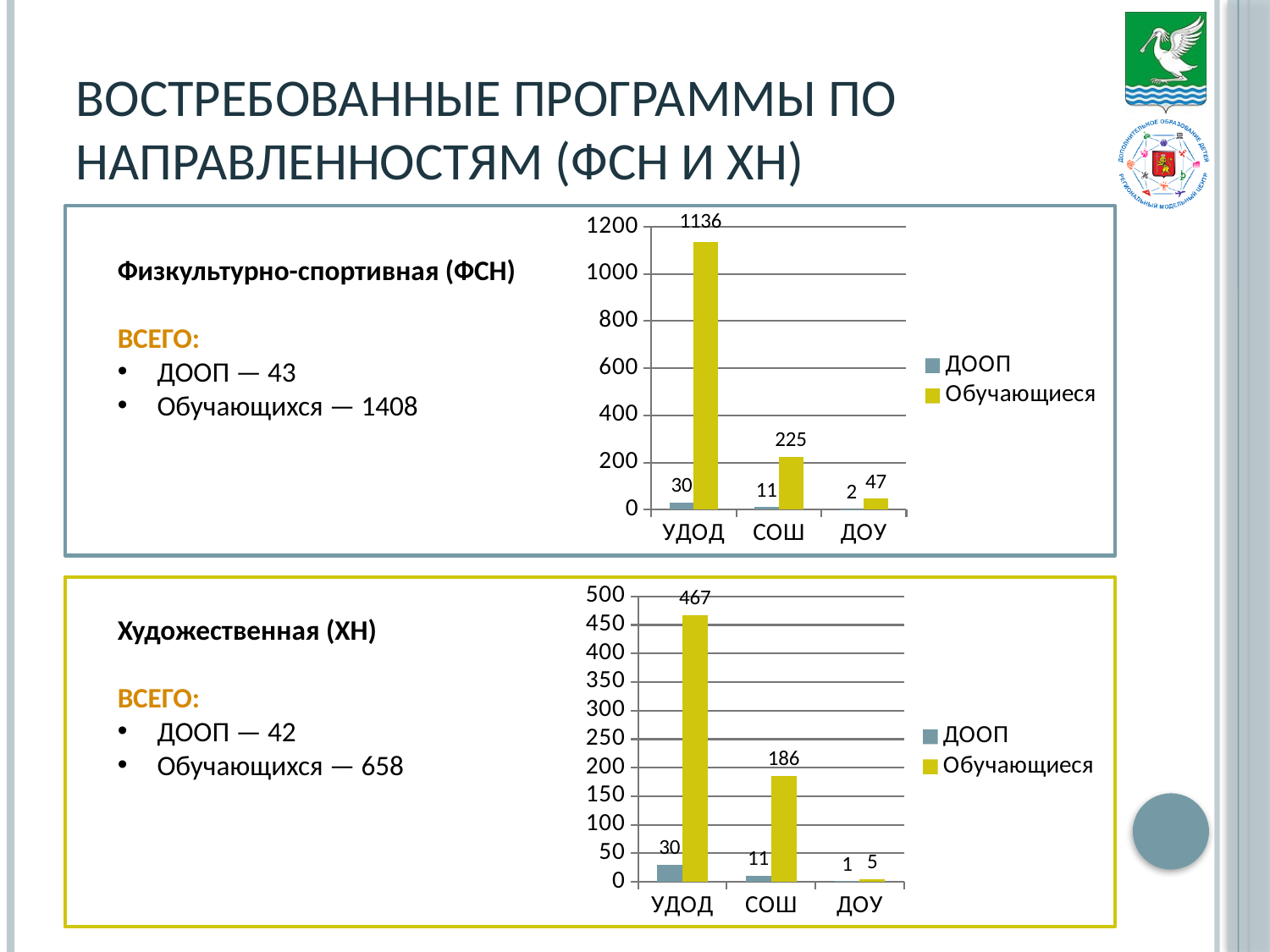
In the bottom chart (Художественная (ХН)), is the value of Обучающиеся for УДОД greater or less than 400? greater In the top chart (Физкультурно-спортивная (ФСН)), how many categories are shown on the x axis? 3 In the bottom chart (Художественная (ХН)), what is the value of Обучающиеся for СОШ? 186 In the bottom chart (Художественная (ХН)), which is larger: ДООП for УДОД or ДООП for СОШ? ДООП for УДОД In the top chart (Физкультурно-спортивная (ФСН)), what is the value of ДООП for СОШ? 11 What type of chart is the top chart (Физкультурно-спортивная (ФСН))? Bar chart How many series does the legend of the bottom chart (Художественная (ХН)) list? 2 In the bottom chart (Художественная (ХН)), what is the value of ДООП for ДОУ? 1 In the top chart (Физкультурно-спортивная (ФСН)), which category has the lowest value for Обучающиеся? ДОУ In the top chart (Физкультурно-спортивная (ФСН)), what is the value of Обучающиеся for УДОД? 1136 In the bottom chart (Художественная (ХН)), which category has the highest value for Обучающиеся? УДОД In the top chart (Физкультурно-спортивная (ФСН)), what is the difference between Обучающиеся for УДОД and for СОШ? 911